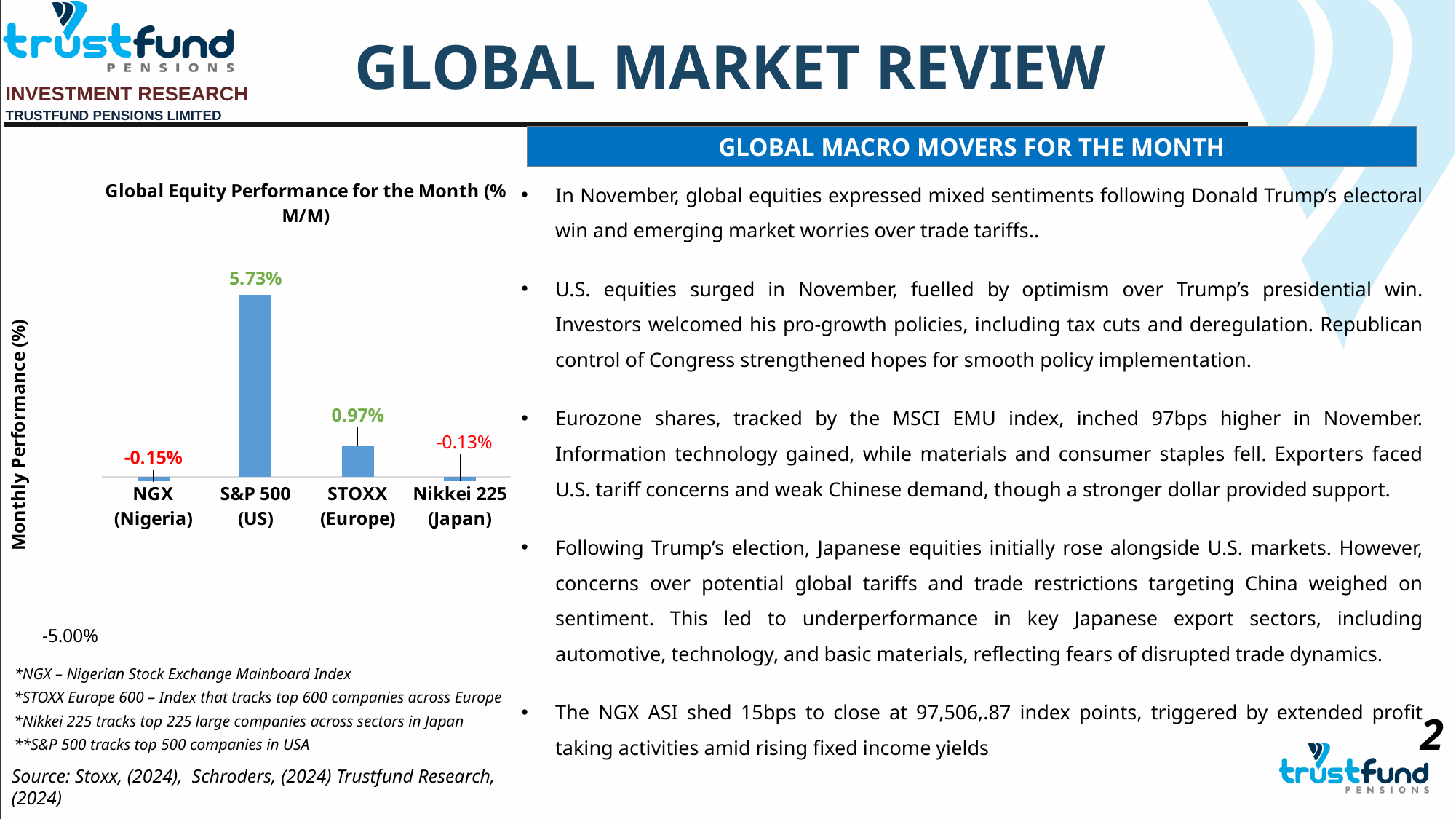
What is the monthly performance value shown for Nikkei 225 (Japan)? -0.13% How many indices are plotted in the chart? 4 What is the label on the vertical axis of the chart? Monthly Performance (%) Which has the higher monthly performance, NGX (Nigeria) or Nikkei 225 (Japan)? Nikkei 225 (Japan) What is the monthly performance value shown for NGX (Nigeria)? -0.15% What type of chart is used to show Global Equity Performance for the Month? Bar chart How many of the plotted indices show a negative monthly performance? 2 What is the difference in monthly performance between the S&P 500 (US) and STOXX (Europe)? 4.76% What is the monthly performance value shown for STOXX (Europe)? 0.97% What is the monthly performance value shown for the S&P 500 (US)? 5.73% Which index has the lowest monthly performance in the chart? NGX (Nigeria) Which index has the highest monthly performance in the chart? S&P 500 (US)